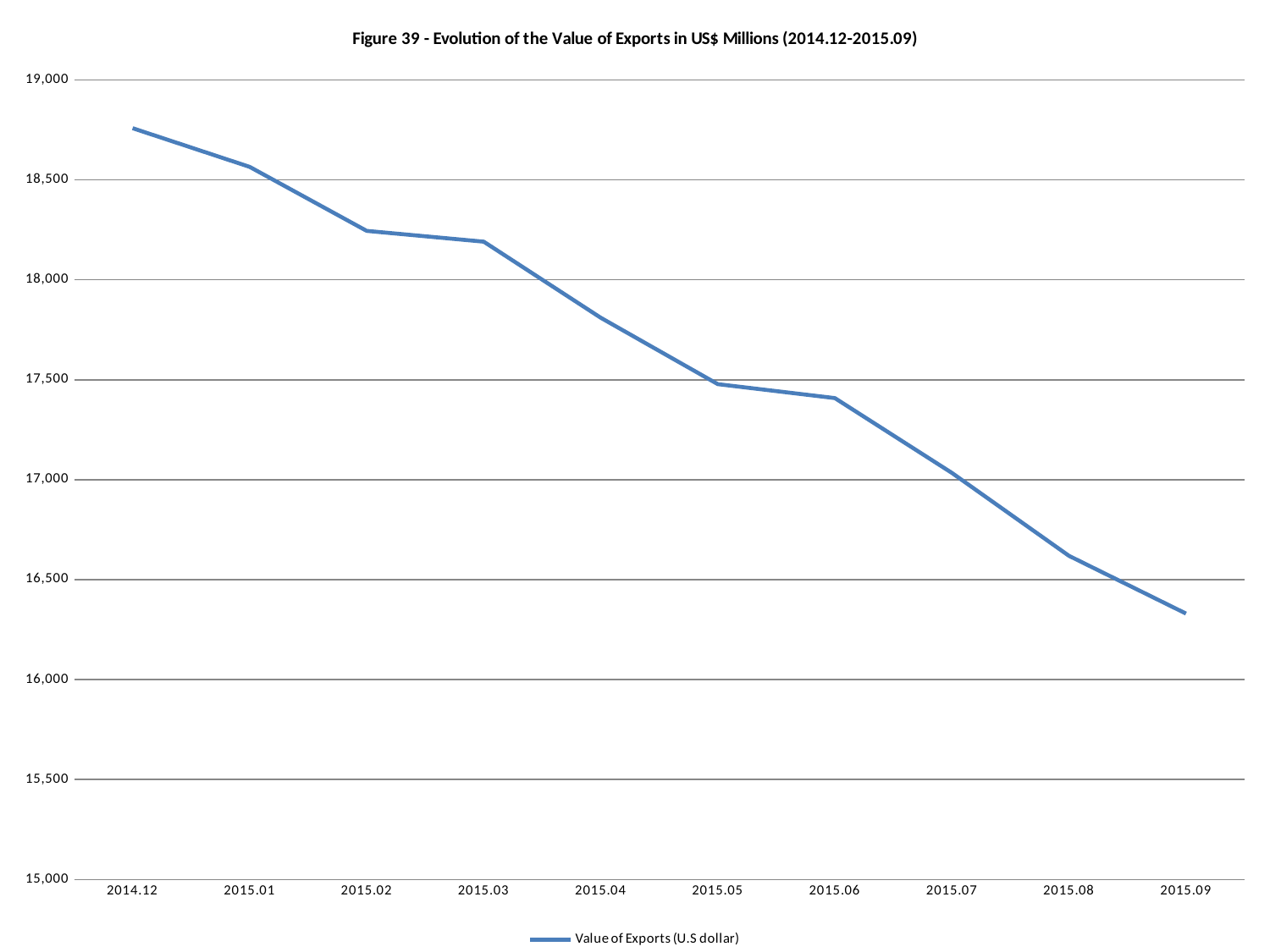
Is the value for 2015.03 greater or less than 18,000? greater How many series does the legend list? 1 Is the value for 2015.09 greater or less than 16,500? less Which is larger, the value of exports in 2015.01 or in 2015.05? 2015.01 Do the values of exports rise or fall from 2014.12 to 2015.09? fall What is the legend entry for the plotted series? Value of Exports (U.S dollar) Which month has the highest value of exports? 2014.12 What kind of chart is shown on the slide? line chart Which month has the lowest value of exports? 2015.09 Is the value for 2014.12 greater or less than 18,500? greater How many time points are plotted along the x axis? 10